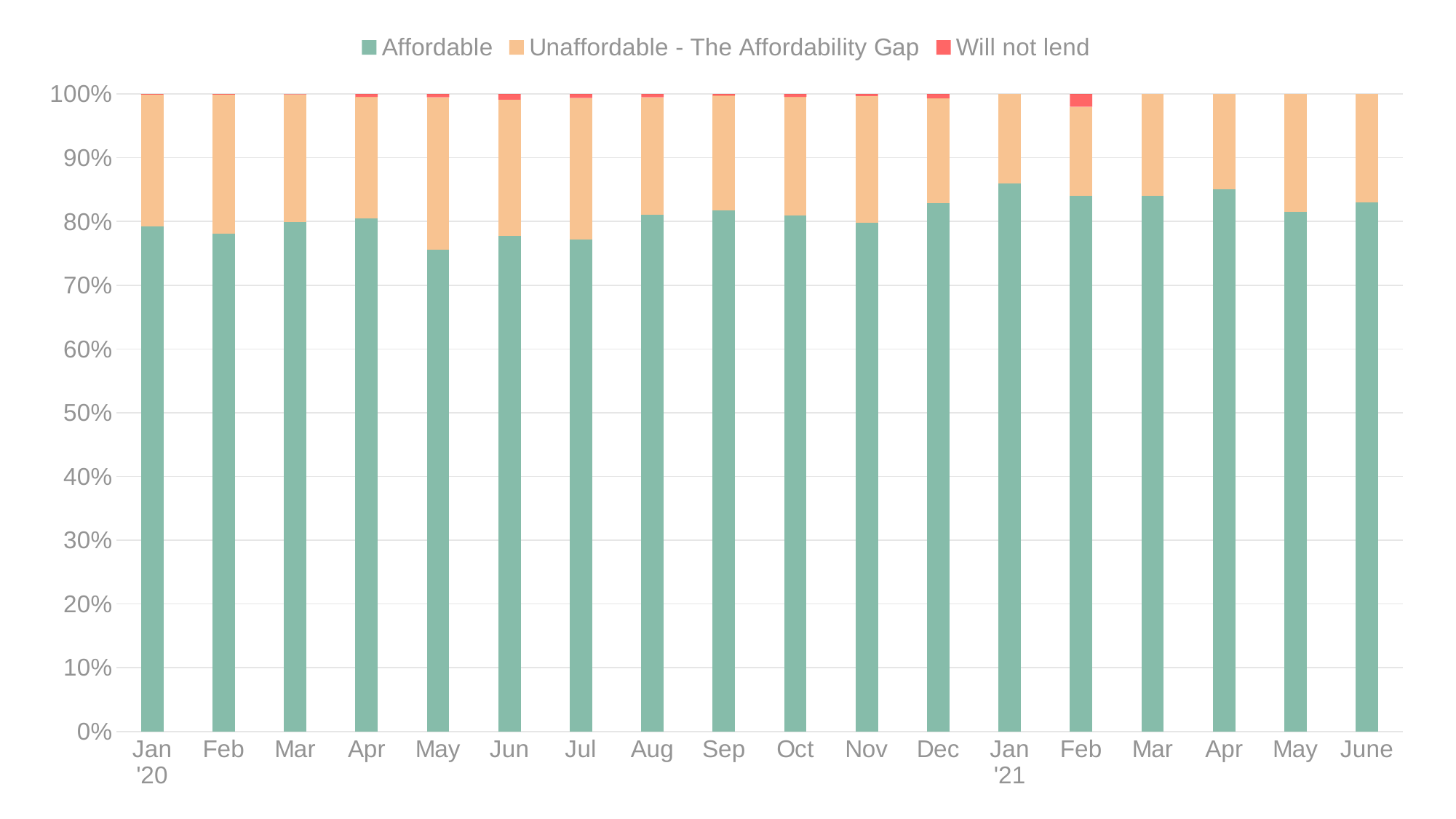
Is the Affordable value for May '20 greater or less than 80%? less Is the Affordable value for Jan '21 greater or less than 80%? greater What colour represents the Affordable series in the legend? Green What kind of chart is shown on the slide? Stacked bar chart How many months are plotted along the x axis? 18 What is the total height of the stacked bar for Jan '20? 100% Which month has the largest Will not lend segment? Feb '21 Which is larger, the Affordable share in Jul '20 or in Dec '20? Dec '20 Is the Affordable value for Dec '20 greater or less than 80%? greater How many series does the legend list? 3 Which month has the lowest Affordable share? May '20 Which is larger, the Affordable share in May '20 or in Jan '21? Jan '21